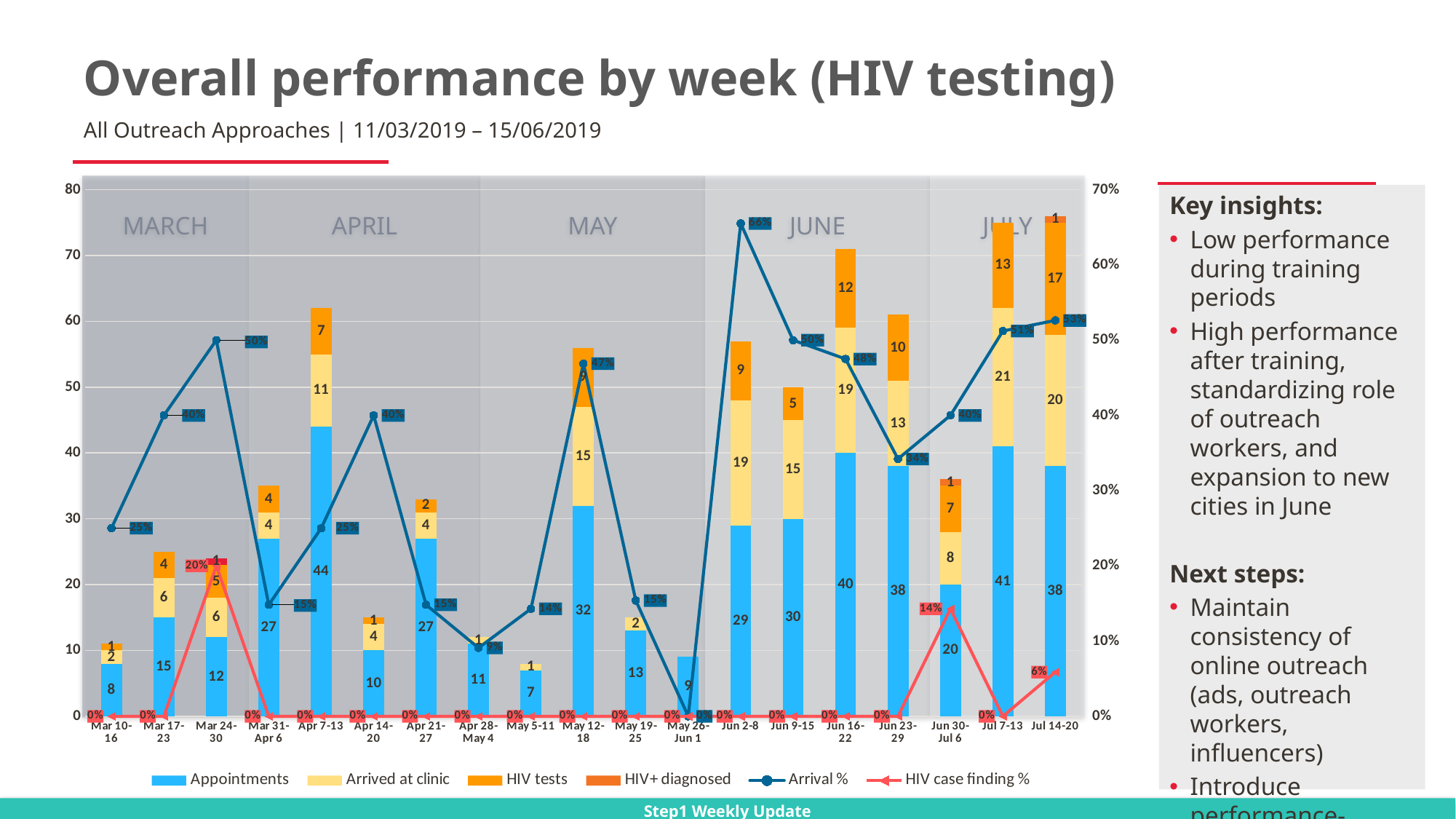
Which week has the highest Arrival % value? Jun 2-8 What is the Appointments value for the week Apr 7-13? 44 Which is larger, the Arrived at clinic value for Jul 7-13 or for Jun 23-29? Jul 7-13 Which week has the highest Appointments value? Apr 7-13 What is the difference between the Appointments values for Jul 7-13 and Jun 30-Jul 6? 21 How many weekly categories are shown on the x axis? 19 What is the HIV case finding % value for the week Jun 30-Jul 6? 14% What type of chart is shown on the slide? Stacked bar chart with line series What is the Arrival % value for the week Jun 2-8? 66% What is the title of the chart's slide? Overall performance by week (HIV testing) How many series does the legend list? 6 What is the HIV tests value for the week Jul 14-20? 17